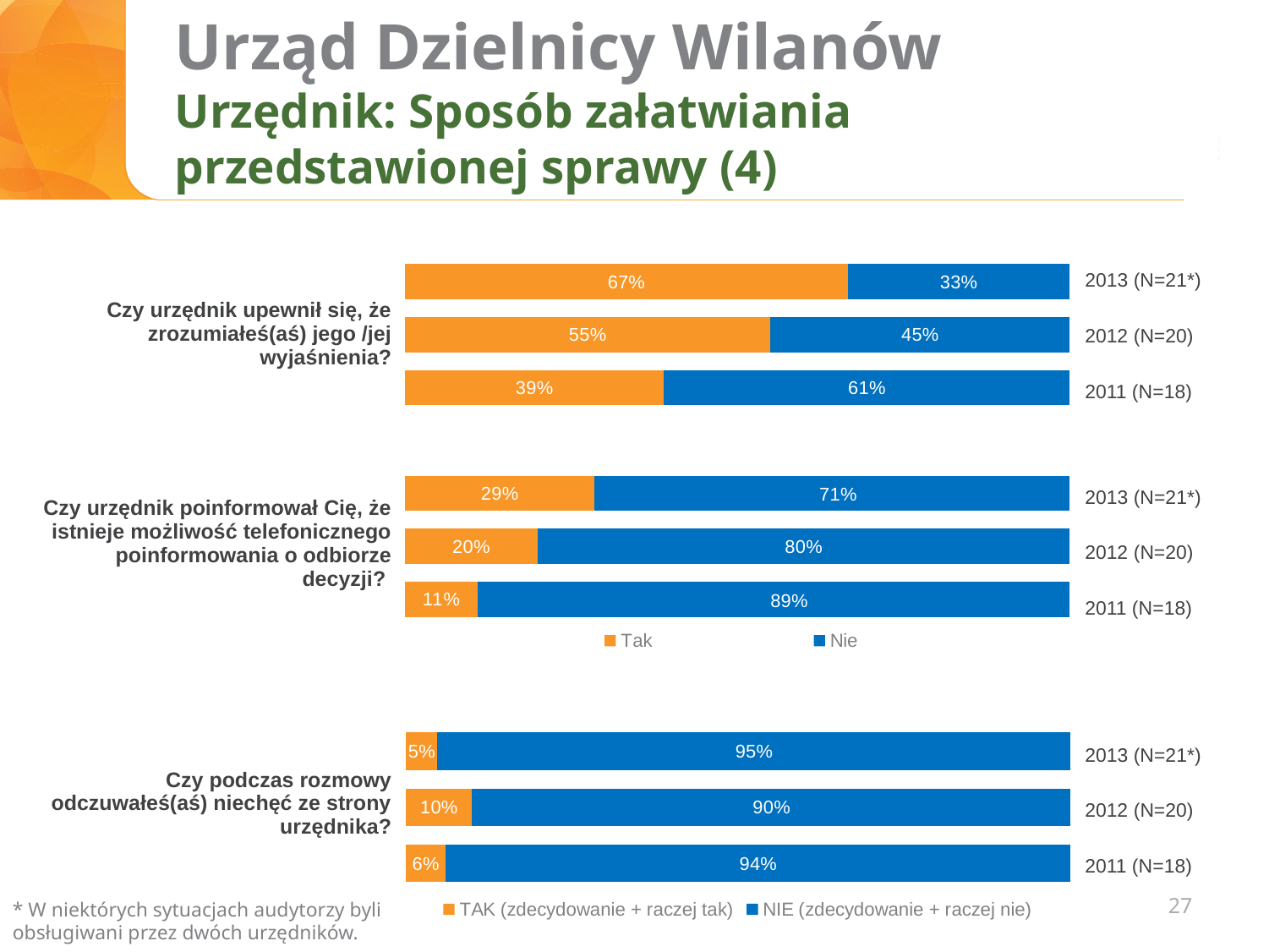
In the bottom chart ("Czy podczas rozmowy odczuwałeś(aś) niechęć..."), is the NIE value for 2011 larger or smaller than the NIE value for 2012? larger In the bottom chart ("Czy podczas rozmowy odczuwałeś(aś) niechęć ze strony urzędnika?"), what is the TAK value for 2012 (N=20)? 10% In the middle chart ("Czy urzędnik poinformował Cię..."), does the Tak share rise or fall from 2011 to 2013? rise In the middle chart ("Czy urzędnik poinformował Cię..."), which year has the lowest Tak value? 2011 (N=18) In the bottom chart ("Czy podczas rozmowy odczuwałeś(aś) niechęć..."), which year has the highest NIE value? 2013 (N=21*) In the top chart ("Czy urzędnik upewnił się..."), what is the difference between the Tak values for 2013 and 2011? 28 percentage points In the top chart ("Czy urzędnik upewnił się..."), what is the Nie value for 2011 (N=18)? 61% In the middle chart ("Czy urzędnik poinformował Cię, że istnieje możliwość telefonicznego poinformowania o odbiorze decyzji?"), what is the Nie value for 2012 (N=20)? 80% In the top chart ("Czy urzędnik upewnił się..."), which year has the highest Tak value? 2013 (N=21*) How many bars does the top chart ("Czy urzędnik upewnił się...") contain? 3 In the top chart ("Czy urzędnik upewnił się, że zrozumiałeś(aś) jego/jej wyjaśnienia?"), what is the Tak value for 2013 (N=21*)? 67% What type of chart is used for the bottom chart ("Czy podczas rozmowy odczuwałeś(aś) niechęć...")? stacked bar chart